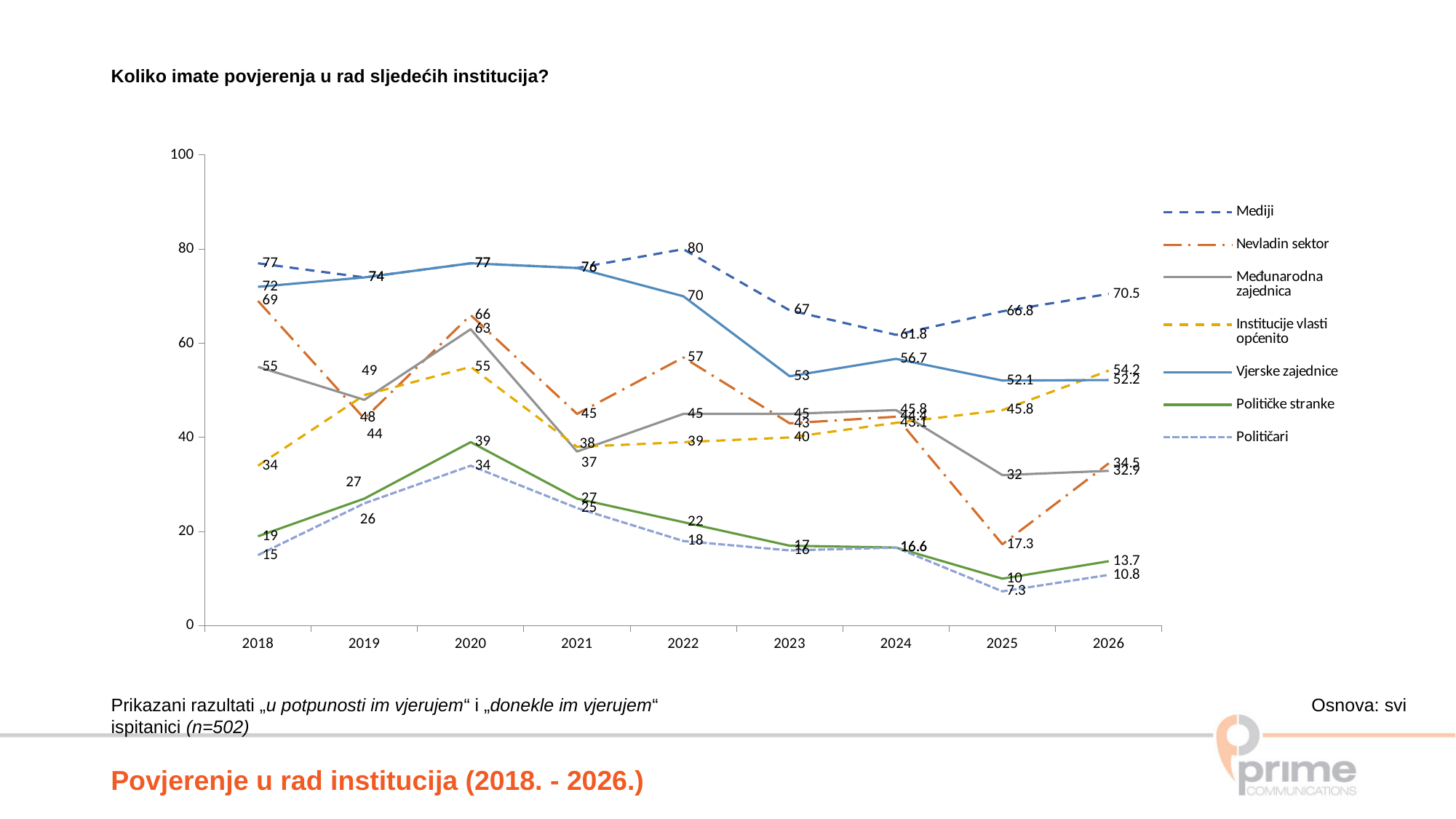
Which series has the highest value in 2026? Mediji What is the difference between the Mediji values in 2022 and 2024? 18.2 What type of chart is shown on the slide? line chart Do the values for Političke stranke rise or fall from 2020 to 2025? fall What is the value for Političari in 2025? 7.3 What is the value for Mediji in 2022? 80 What is the value for Političke stranke in 2020? 39 How many series does the legend list? 7 What is the value for Institucije vlasti općenito in 2026? 54.2 Which series has the lowest value in 2026? Političari What is the value for Nevladin sektor in 2025? 17.3 How many years are shown on the x axis? 9